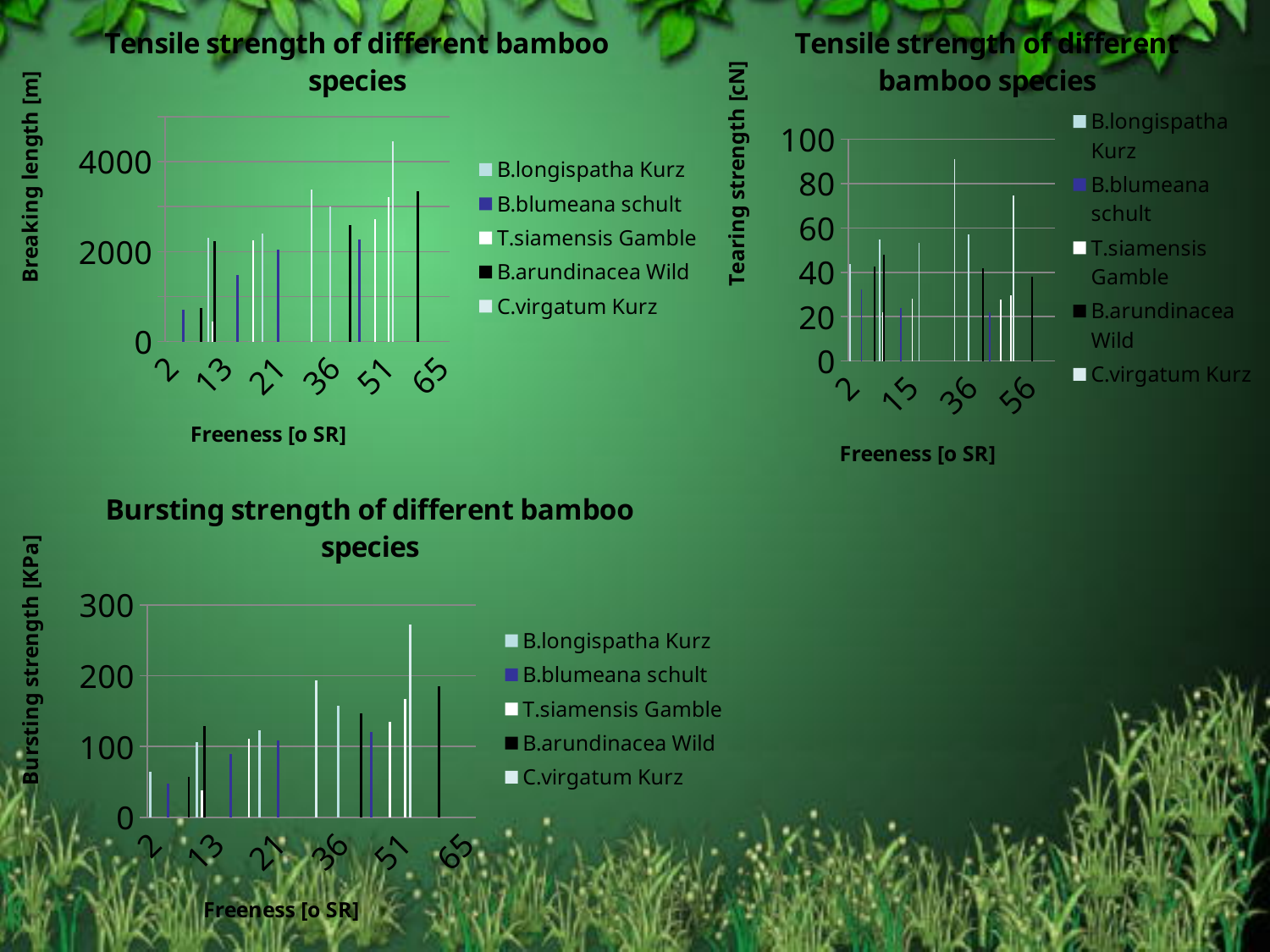
In the bottom-left chart 'Bursting strength of different bamboo species', is the tallest bar greater or less than 300? less How many freeness categories are shown on the x axis of the top-right chart (Tearing strength [cN])? 4 How many series does the legend of the top-left chart (Breaking length [m]) list? 5 In the bottom-left chart 'Bursting strength of different bamboo species', is the tallest bar greater or less than 200? greater How many freeness categories are shown on the x axis of the top-left chart (Breaking length [m])? 6 What is the x-axis title of the bottom-left chart 'Bursting strength of different bamboo species'? Freeness [o SR] In the top-left chart (Breaking length [m]), is the tallest bar greater or less than 4000? greater What kind of chart is the top-left chart titled 'Tensile strength of different bamboo species' with the 'Breaking length [m]' axis? Bar chart What is the y-axis title of the top-right chart? Tearing strength [cN] How many series does the legend of the bottom-left chart 'Bursting strength of different bamboo species' list? 5